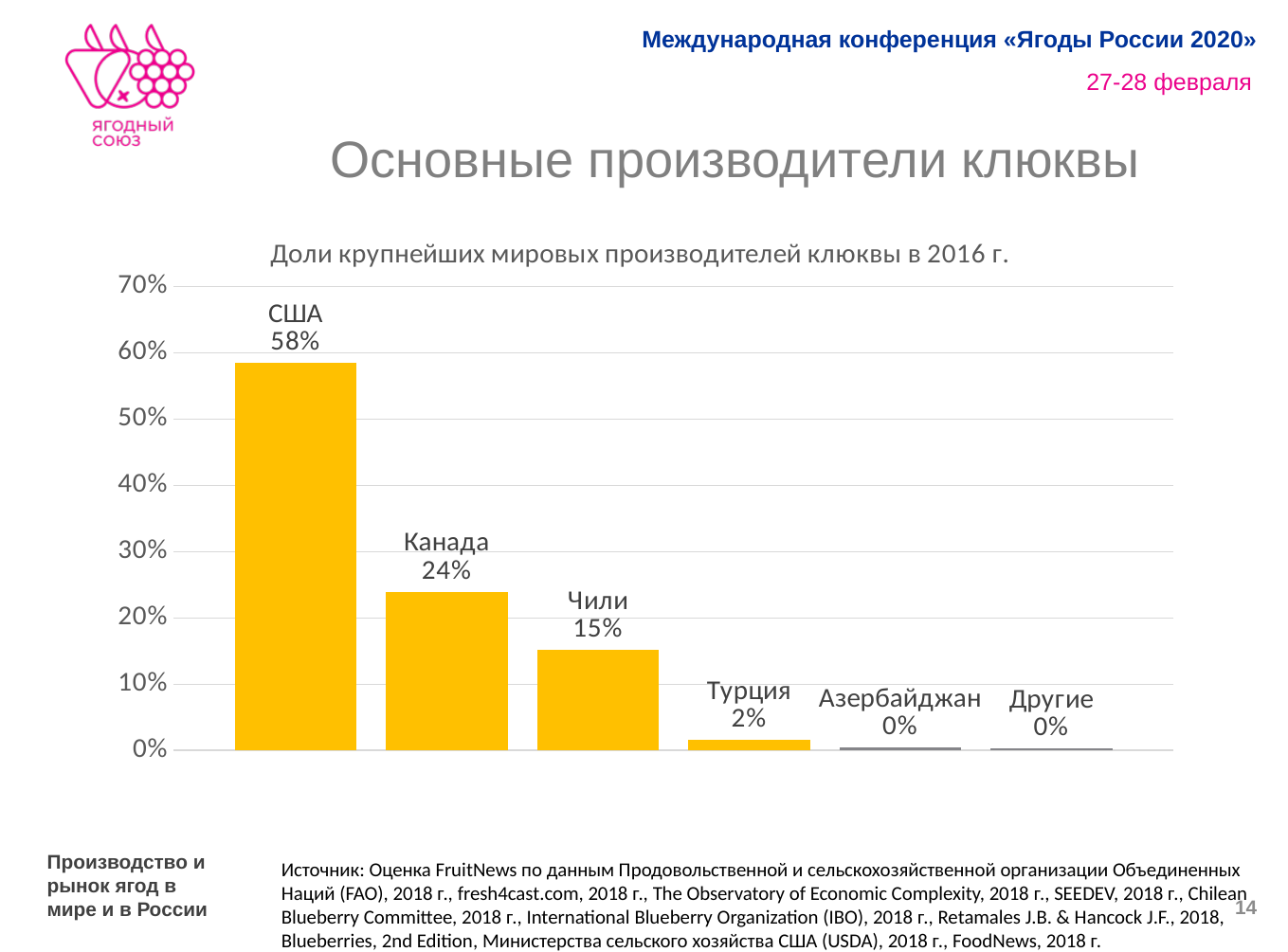
How many categories are shown on the x axis of the chart? 6 Which is larger, the share for Чили or the share for Турция? Чили Is the value for Канада greater or less than 20%? greater What is the share shown for Чили (Chile)? 15% What is the difference between the shares of США and Канада? 34% What is the share shown for США (USA) in the chart? 58% Which category has the highest share in the chart? США What is the difference between the shares of Канада and Чили? 9% What is the share shown for Канада (Canada)? 24% What is the title of the chart? Доли крупнейших мировых производителей клюквы в 2016 г. What kind of chart is shown on the slide? bar chart What is the share shown for Турция (Turkey)? 2%